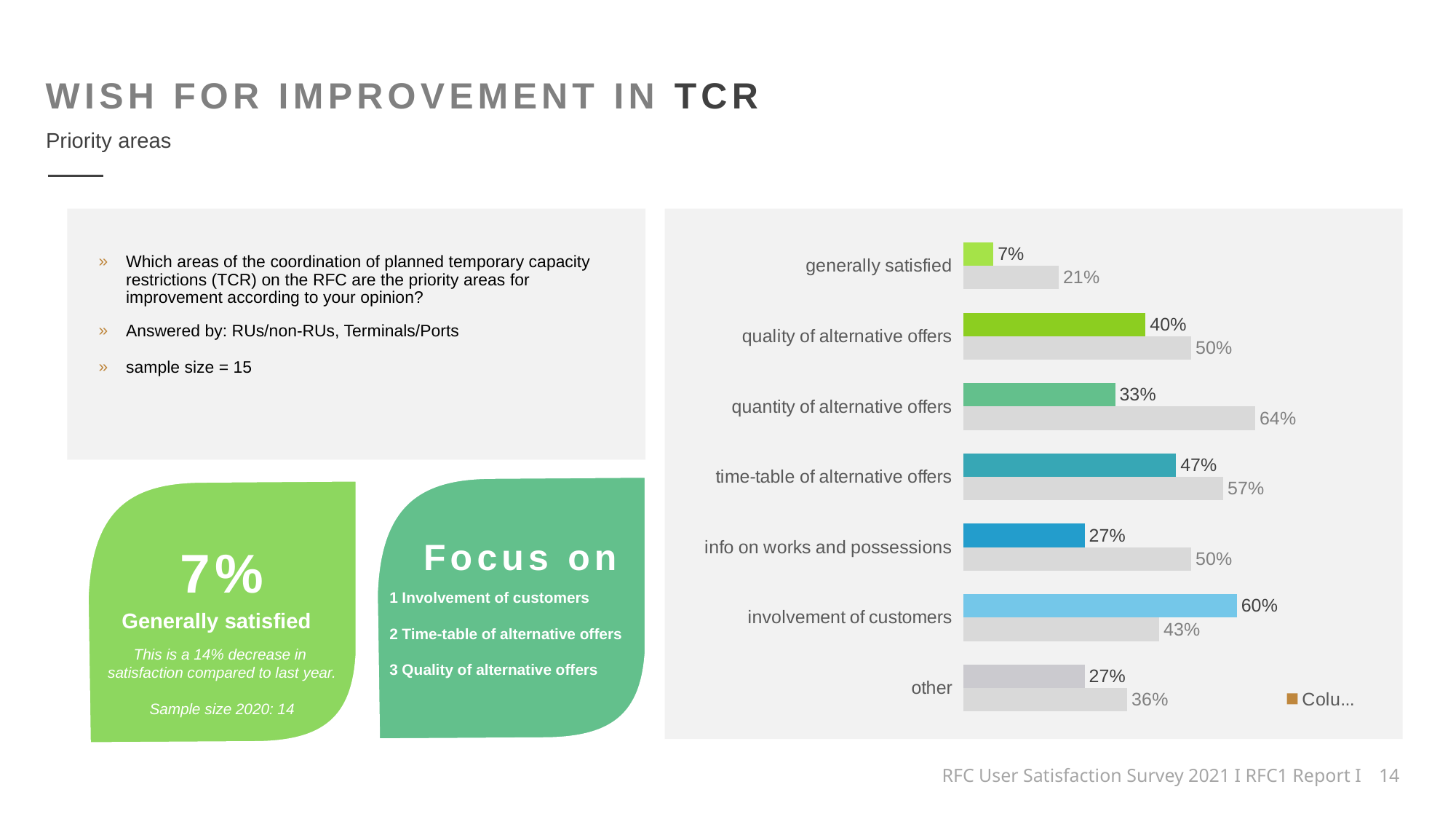
Which category has the highest value among the grey (lower) bars? quantity of alternative offers Which category has the highest value among the coloured (upper) bars? involvement of customers What is the value of the coloured (upper) bar for 'involvement of customers'? 60% What is the value of the grey (lower) bar for 'info on works and possessions'? 50% What is the value of the grey (lower) bar for 'quantity of alternative offers'? 64% What is the value of the coloured (upper) bar for 'generally satisfied'? 7% What is the difference between the grey bar and the coloured bar for 'quantity of alternative offers'? 31% For 'time-table of alternative offers', which is larger: the coloured bar or the grey bar? the grey bar Which category has the lowest value among the coloured (upper) bars? generally satisfied What is the difference between the coloured bar and the grey bar for 'involvement of customers'? 17% What kind of chart is shown on the slide? bar chart How many categories are shown on the chart? 7